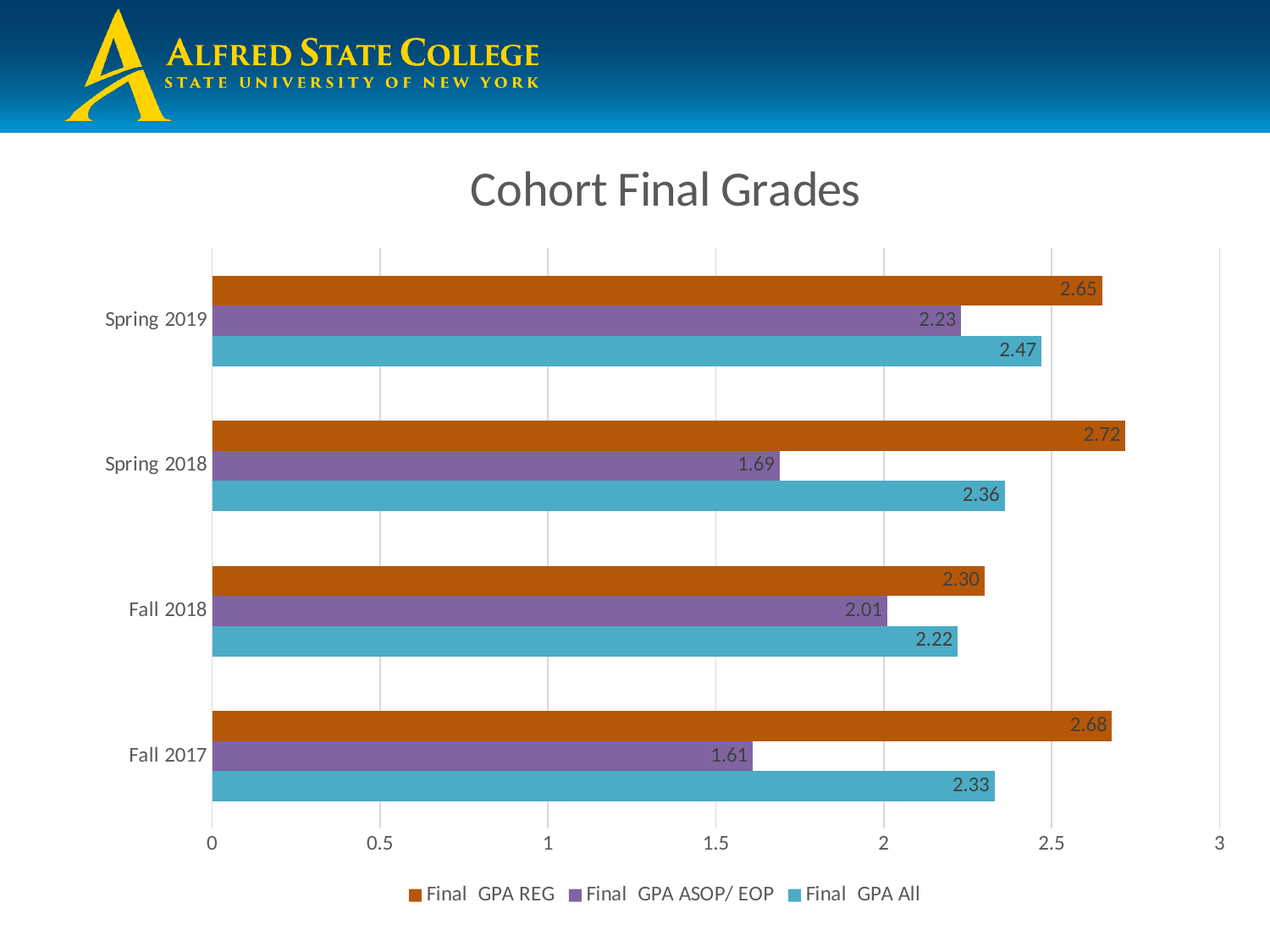
What is the Final GPA REG value for Spring 2018? 2.72 How many cohorts are shown on the chart? 4 What kind of chart is shown on the slide? Bar chart What is the Final GPA ASOP/ EOP value for Fall 2017? 1.61 How many series does the legend list? 3 Which is larger for Fall 2018: the Final GPA REG value or the Final GPA All value? Final GPA REG Which cohort has the lowest Final GPA REG value? Fall 2018 What is the difference between the Final GPA REG and Final GPA ASOP/ EOP values for Spring 2018? 1.03 What is the difference between the Final GPA All values for Spring 2019 and Fall 2017? 0.14 Which cohort has the highest Final GPA ASOP/ EOP value? Spring 2019 What is the title of the chart? Cohort Final Grades What is the Final GPA All value for Spring 2019? 2.47